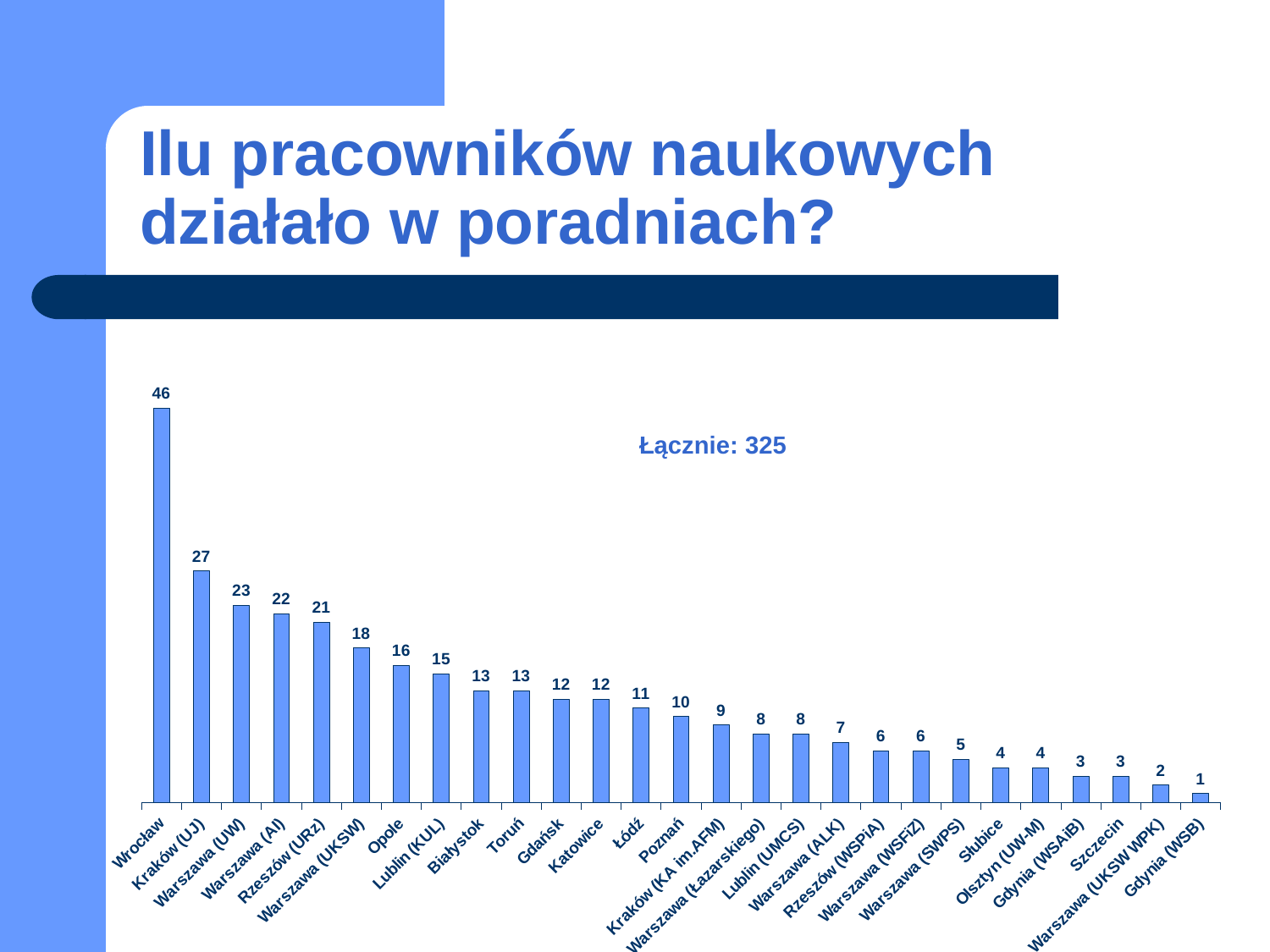
What is the difference between the values for Wrocław and Kraków (UJ)? 19 What total is stated on the chart (Łącznie)? 325 What is the value for Poznań? 10 How many categories are shown on the x axis? 27 What is the value for Opole? 16 Which category has the highest value? Wrocław What is the difference between the values for Lublin (KUL) and Lublin (UMCS)? 7 How many research staff are shown for Wrocław? 46 Do the values rise or fall from left to right along the x axis? Fall Which category has the lowest value? Gdynia (WSB) Which is larger, the value for Warszawa (UW) or the value for Rzeszów (URz)? Warszawa (UW) What kind of chart is shown on the slide? Bar chart